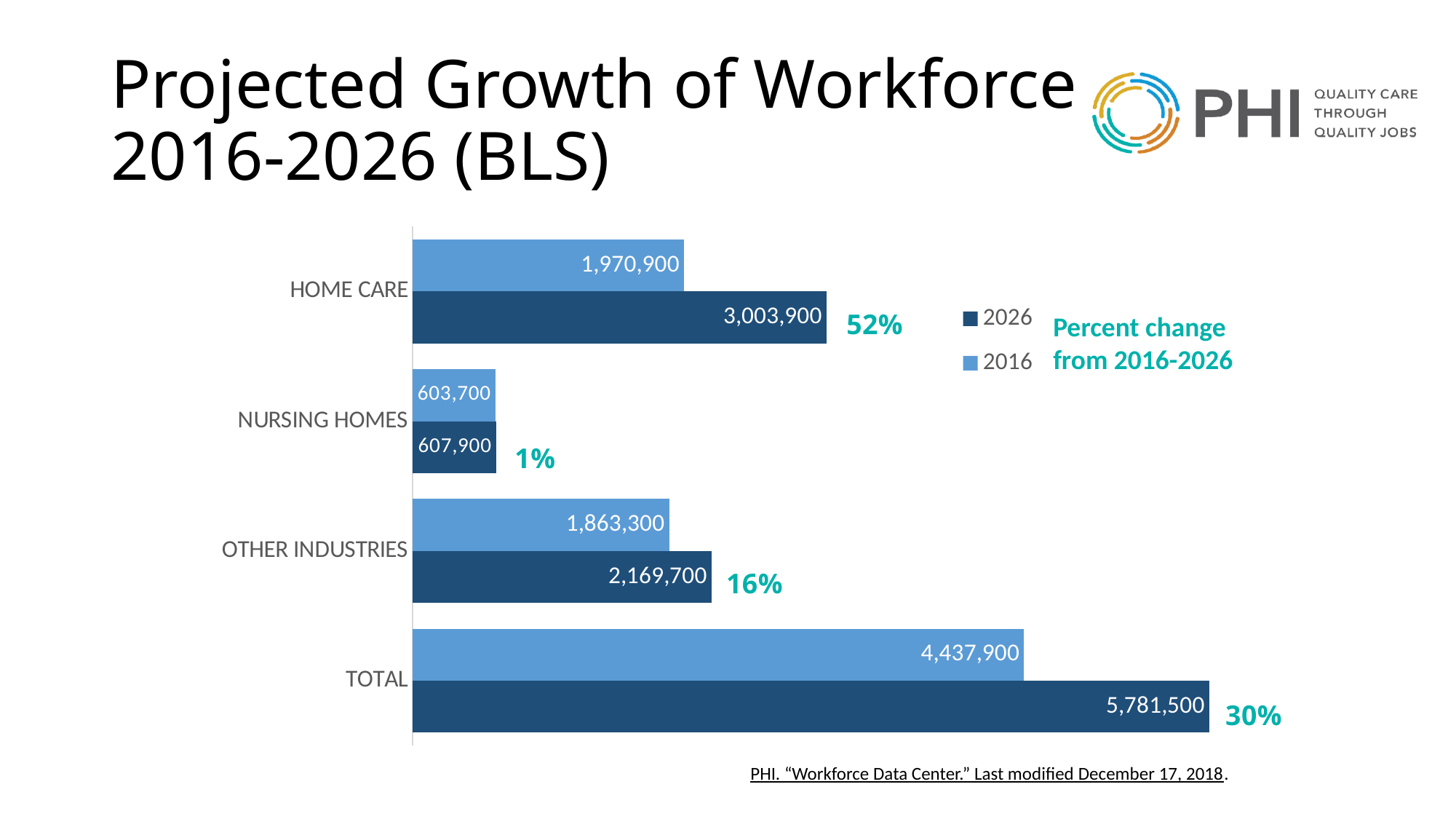
Excluding TOTAL, which category has the highest 2016 value? HOME CARE What kind of chart is shown on the slide? Bar chart How many categories are shown on the chart? 4 What is the 2026 value for OTHER INDUSTRIES? 2,169,700 What is the percent change from 2016-2026 shown for HOME CARE? 52% What is the 2016 value for TOTAL? 4,437,900 What is the difference between the 2026 and 2016 values for HOME CARE? 1,033,000 What is the 2016 value for HOME CARE? 1,970,900 What is the 2026 value for NURSING HOMES? 607,900 How many series does the legend list? 2 Excluding TOTAL, which category has the lowest 2026 value? NURSING HOMES Which is larger, the 2026 value for HOME CARE or the 2026 value for OTHER INDUSTRIES? HOME CARE